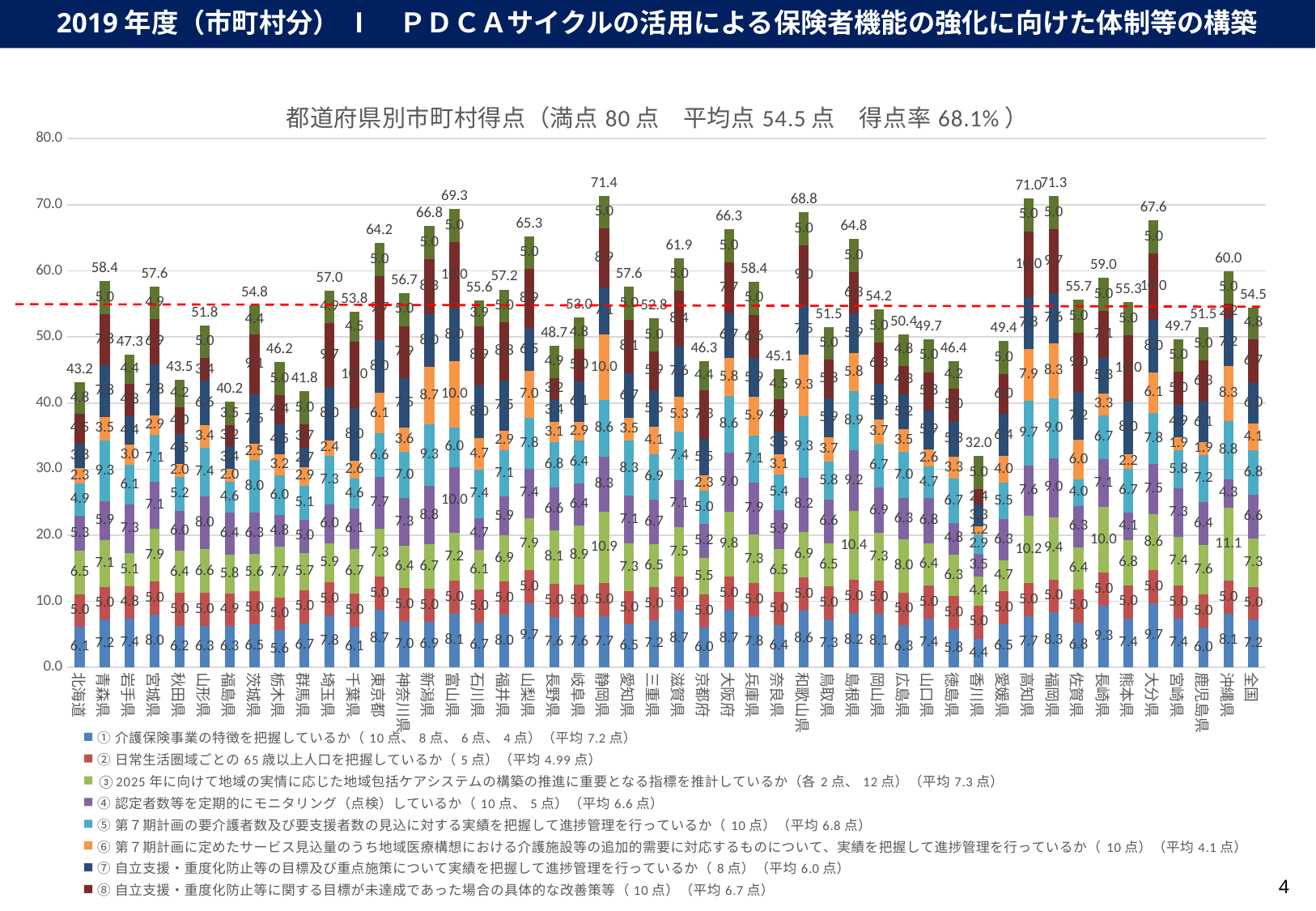
Which prefecture has the lowest total score? 香川県 What is the difference between the total scores of 全国 and 北海道? 11.3 How many series does the legend list? 8 What is the total score for 全国? 54.5 What is the difference between the total scores of 静岡県 and 香川県? 39.4 What is the total score for 北海道? 43.2 What kind of chart is shown on the slide? Stacked bar chart Which has the higher total score, 東京都 or 大阪府? 大阪府 According to the chart title, what is the average score (平均点)? 54.5 点 What is the total score for 沖縄県? 60.0 Is the total score for 香川県 greater or less than 40? less Is the total score for 静岡県 greater or less than 70? greater